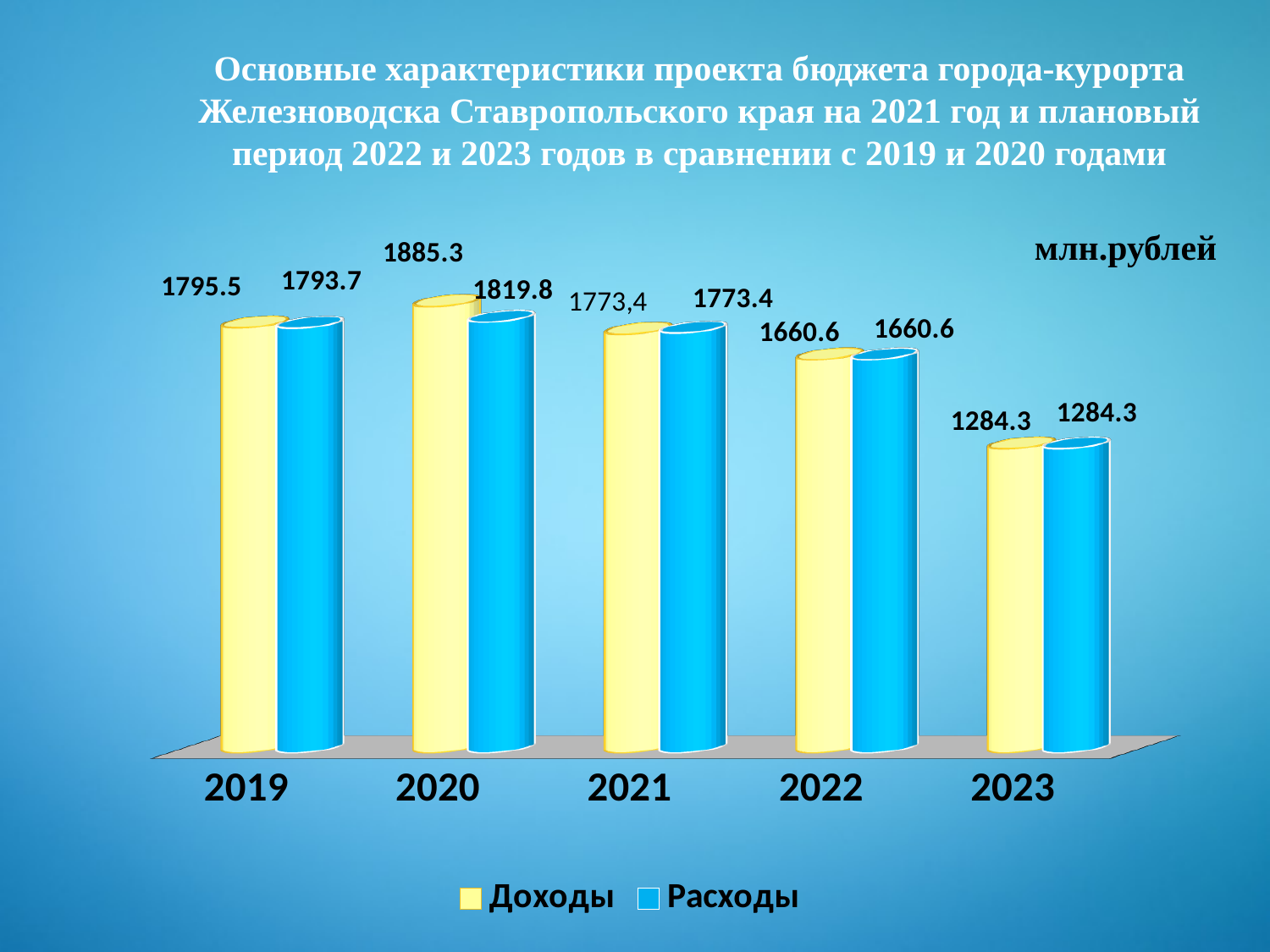
Which year has the highest value of Доходы? 2020 What is the difference between Доходы in 2019 and Доходы in 2023? 511.2 Which is larger: Расходы in 2020 or Расходы in 2021? Расходы in 2020 How many series does the legend list? 2 How many years are shown on the x axis? 5 What is the value of Расходы for 2023? 1284.3 What is the value of Расходы for 2019? 1793.7 What is the value of Доходы for 2020? 1885.3 What is the value of Доходы for 2022? 1660.6 What is the difference between Доходы and Расходы in 2020? 65.5 What kind of chart is shown on the slide? Bar chart Which year has the lowest value of Расходы? 2023